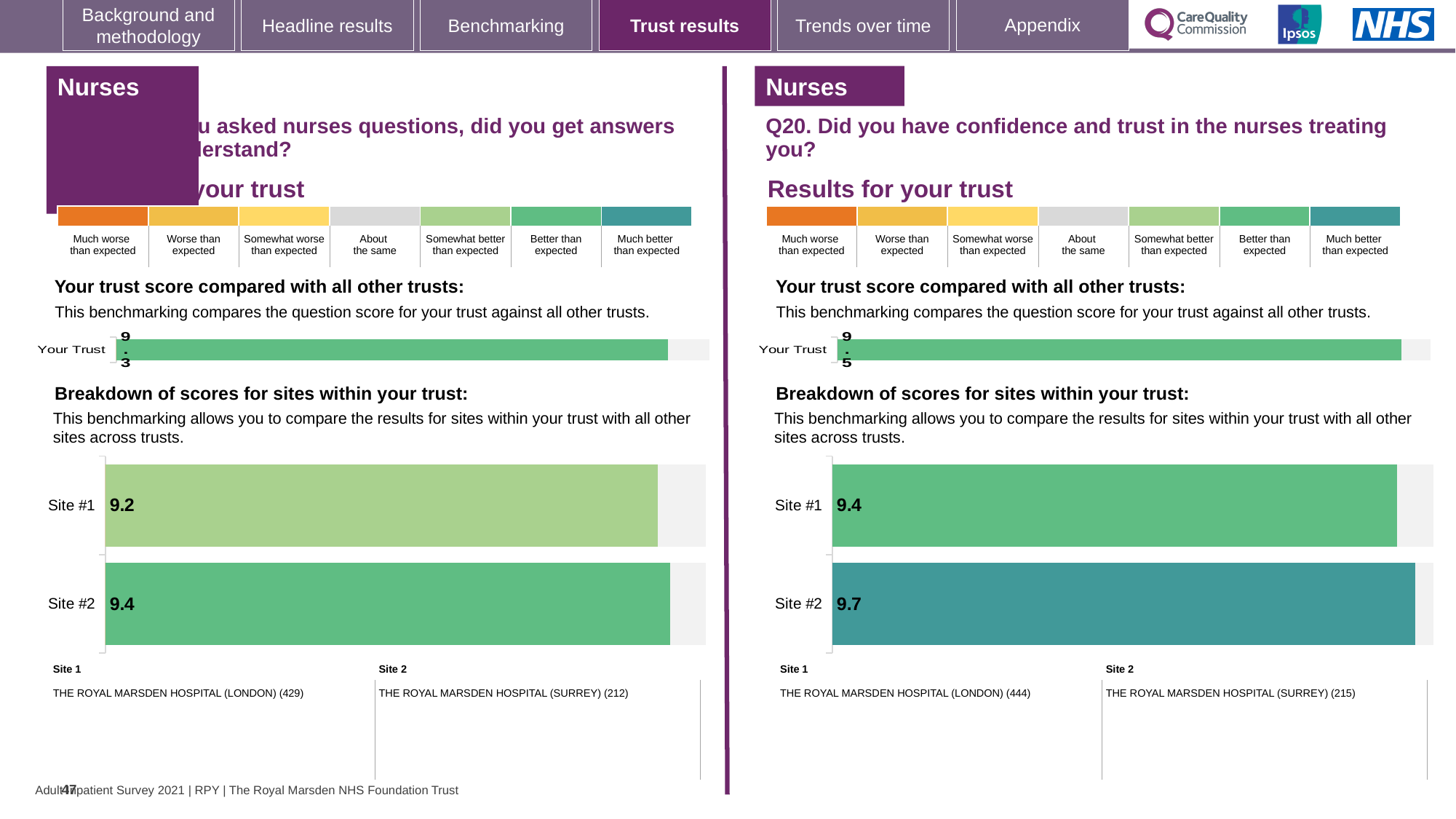
On the right-hand (Q20) 'Your Trust' chart, what is the trust score shown? 9.5 On the right-hand (Q20) site breakdown chart, which site has the higher score? Site #2 On the right-hand (Q20) site breakdown chart, what is the difference between the Site #2 and Site #1 scores? 0.3 On the right-hand (Q20) site breakdown chart, what is the score for Site #2? 9.7 On the left-hand site breakdown chart, what is the difference between the Site #2 and Site #1 scores? 0.2 On the left-hand 'Your Trust' chart, what is the trust score shown? 9.3 What type of chart is the right-hand (Q20) site breakdown chart? Bar chart On the right-hand (Q20) site breakdown chart, what is the score for Site #1? 9.4 On the left-hand site breakdown chart, what is the score for Site #1? 9.2 On the left-hand site breakdown chart, which site has the lower score? Site #1 How many sites are shown on the right-hand (Q20) site breakdown chart? 2 On the left-hand site breakdown chart, what is the score for Site #2? 9.4